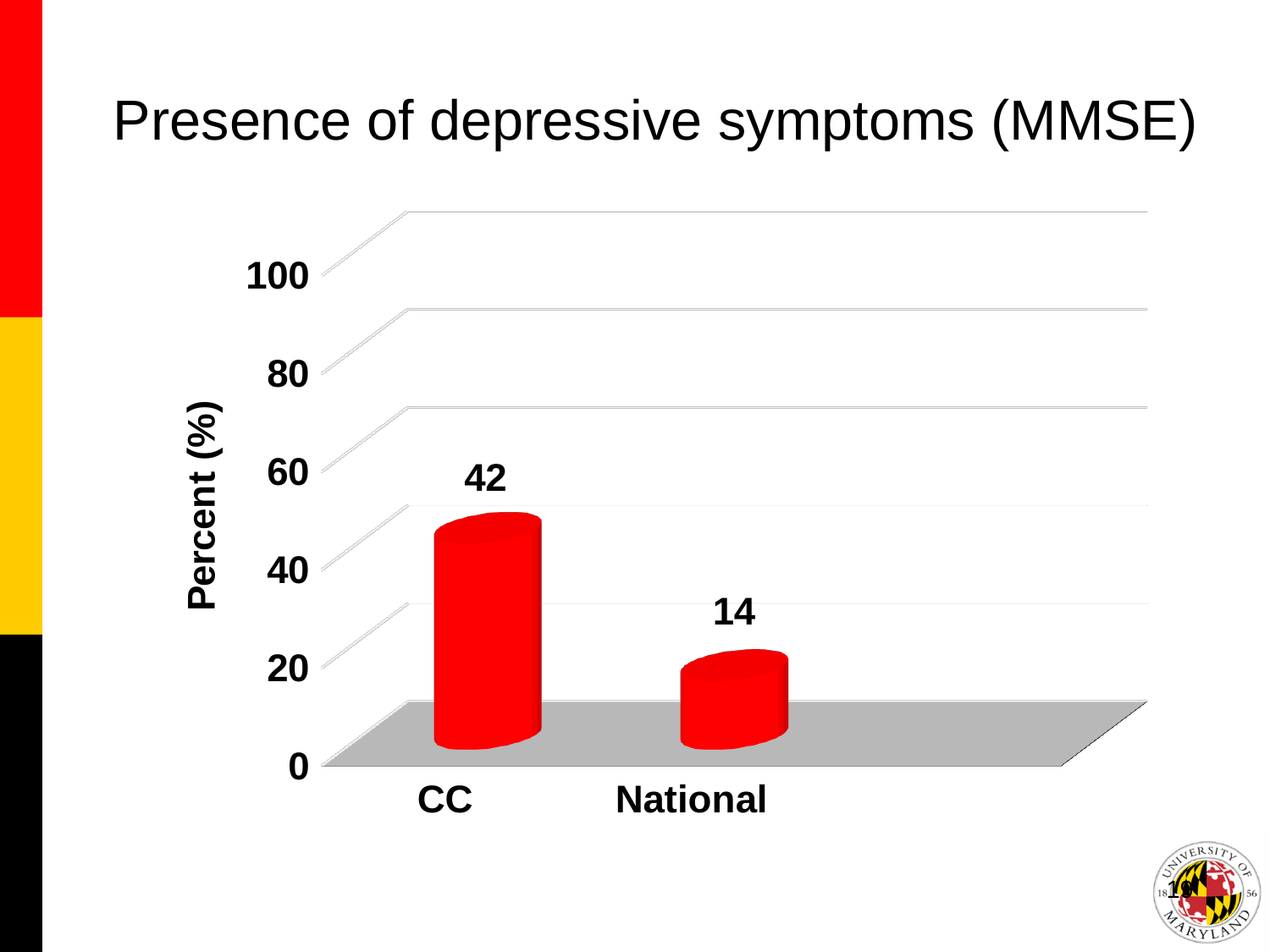
Is the value for CC greater or less than 60? less Is the value for National greater or less than 20? less Which category has the highest value? CC What is the value for National? 14 What is the difference between the values for CC and National? 28 What is the label of the vertical axis? Percent (%) How many categories are shown on the x axis? 2 What is the title of the chart? Presence of depressive symptoms (MMSE) What is the value for CC? 42 Which is larger, the value for CC or the value for National? CC What kind of chart is shown on the slide? bar chart Which category has the lowest value? National